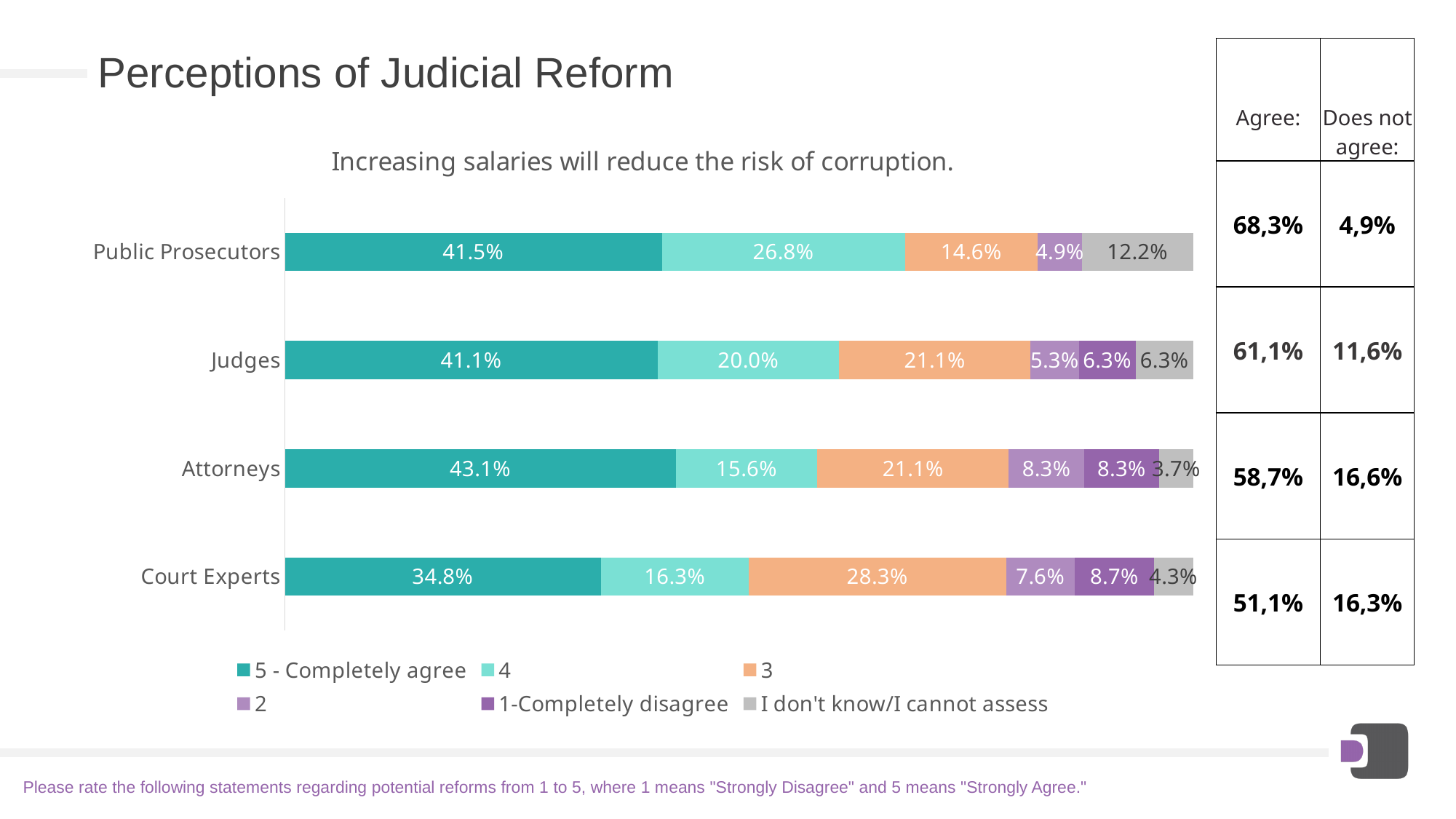
What percentage of Attorneys answered "I don't know/I cannot assess"? 3.7% How many series does the chart legend list? 6 What percentage of Public Prosecutors answered "5 - Completely agree"? 41.5% Which group has the highest share of "5 - Completely agree" responses? Attorneys What percentage of Judges answered "1-Completely disagree"? 6.3% How many respondent groups (categories) are shown on the chart? 4 What is the difference between the share of Public Prosecutors and the share of Judges who gave a rating of 4? 6.8 percentage points What percentage of Court Experts gave a rating of 3? 28.3% What kind of chart is shown on the slide? Stacked bar chart Which group has a larger share of rating 3 responses, Judges or Public Prosecutors? Judges Which group has the lowest share of "5 - Completely agree" responses? Court Experts What is the title of the chart? Increasing salaries will reduce the risk of corruption.